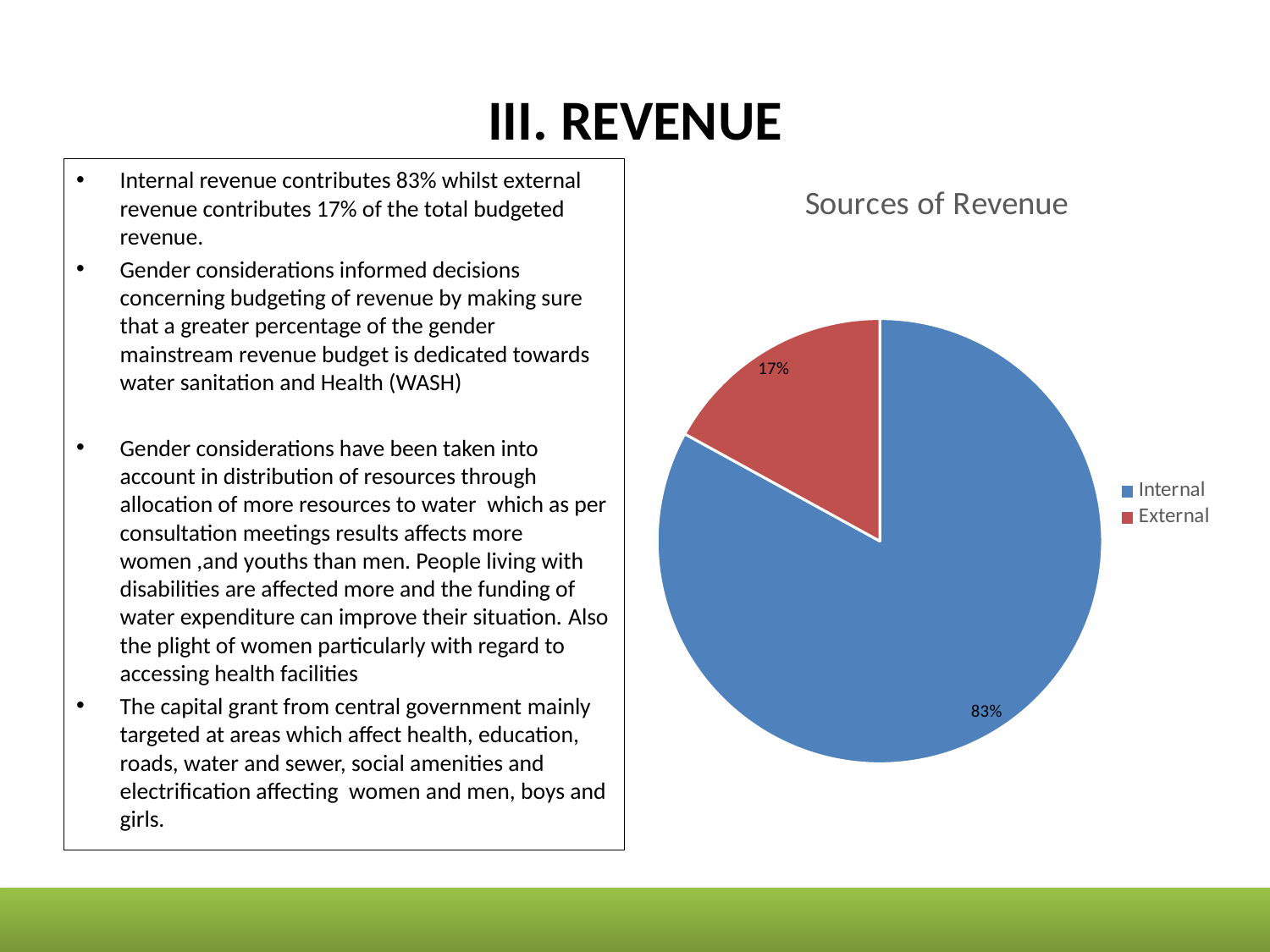
How many entries does the legend list? 2 What share of the pie does External revenue represent? 17% Which source of revenue has the largest share? Internal What is the title of the chart? Sources of Revenue What kind of chart is shown on the slide? pie chart Which is larger, the Internal share or the External share? Internal Which source of revenue has the smallest share? External How many slices does the pie chart have? 2 What colour is the Internal slice? blue What is the difference in percentage points between the Internal and External shares? 66 What share of the pie does Internal revenue represent? 83%